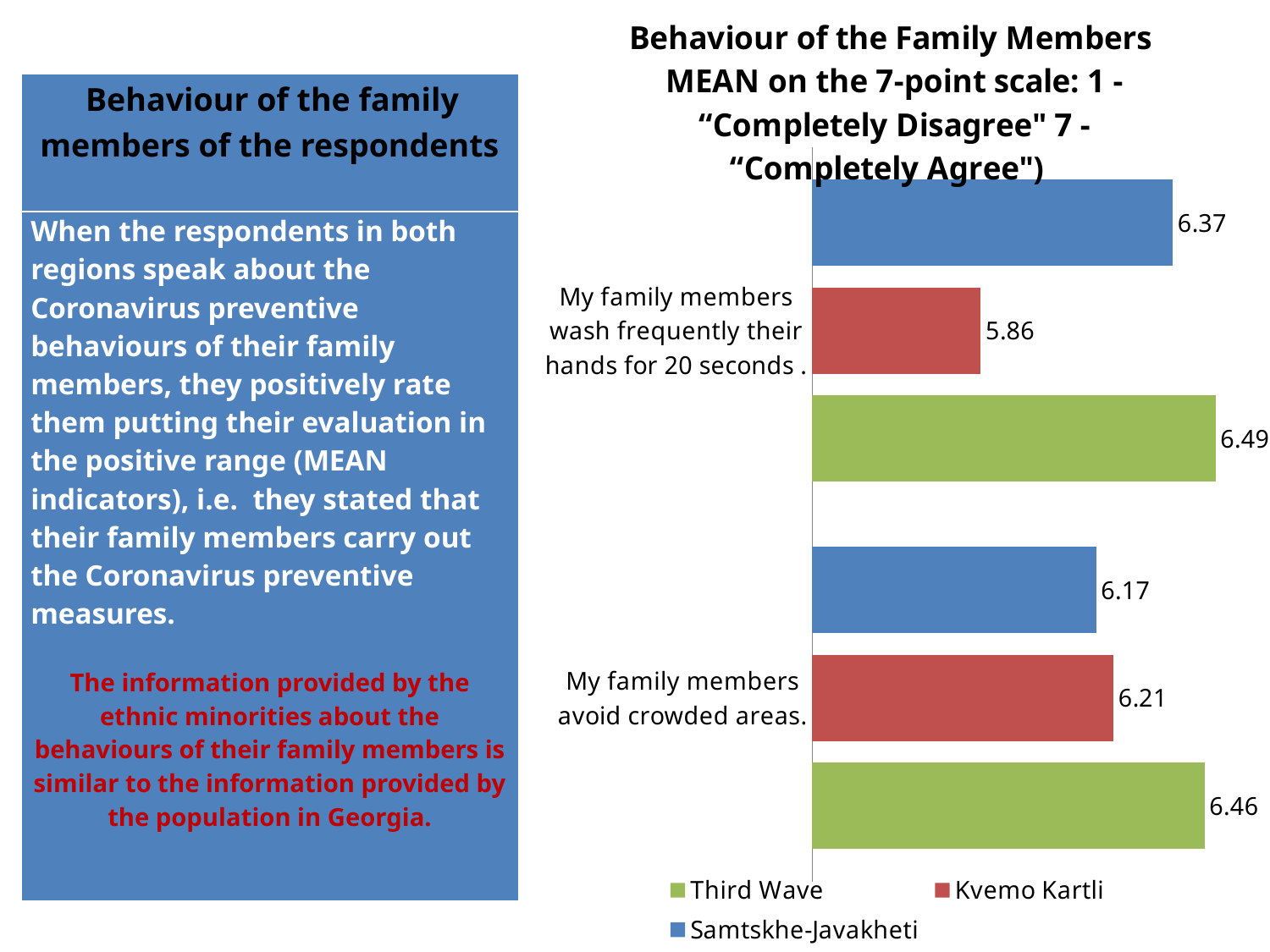
How many series does the legend list? 3 Which series has the lowest value on "My family members wash frequently their hands for 20 seconds"? Kvemo Kartli What is the difference between the Third Wave and Kvemo Kartli values on "My family members wash frequently their hands for 20 seconds"? 0.63 What is the value for Samtskhe-Javakheti on "My family members wash frequently their hands for 20 seconds"? 6.37 What is the value for Kvemo Kartli on "My family members avoid crowded areas"? 6.21 What is the value for Third Wave on "My family members avoid crowded areas"? 6.46 What is the value for Kvemo Kartli on "My family members wash frequently their hands for 20 seconds"? 5.86 Which series has the highest value on "My family members avoid crowded areas"? Third Wave Which is larger: the Samtskhe-Javakheti value for washing hands or the Samtskhe-Javakheti value for avoiding crowded areas? Washing hands (6.37) What kind of chart is shown on the slide? Bar chart What is the difference between the Kvemo Kartli and Samtskhe-Javakheti values on "My family members avoid crowded areas"? 0.04 How many categories (statements) are shown on the chart? 2